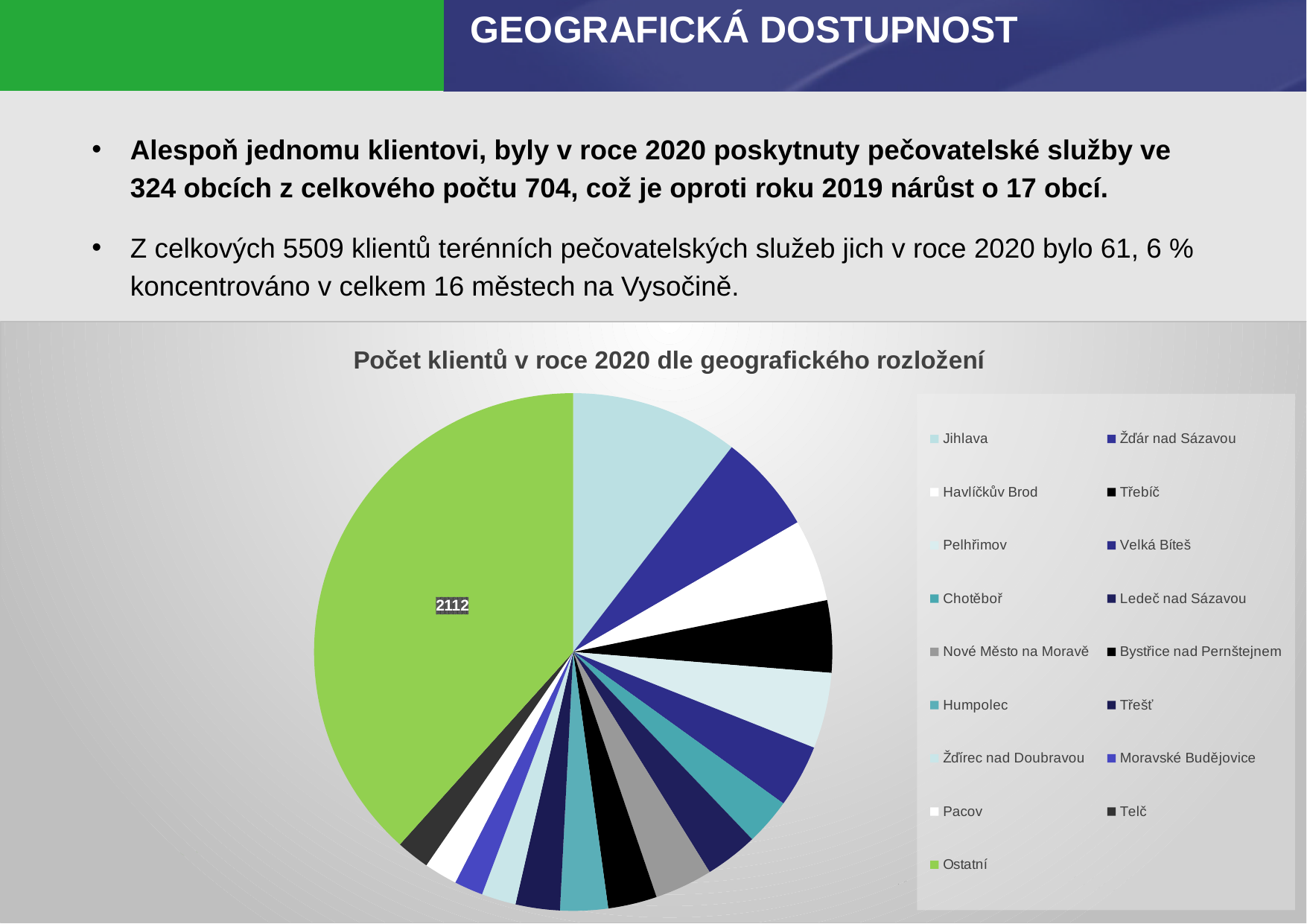
Which slice is the only one with a printed data label? Ostatní Which slice is larger, Jihlava or Žďár nad Sázavou? Jihlava What colour is the Ostatní slice? green Which slice is larger, Jihlava or Telč? Jihlava What is the title of the chart? Počet klientů v roce 2020 dle geografického rozložení Which slice is larger, Ostatní or Jihlava? Ostatní How many categories does the chart's legend list? 17 Which category has the largest slice of the pie? Ostatní What kind of chart is shown on the slide? pie chart What value is shown for the Ostatní slice? 2112